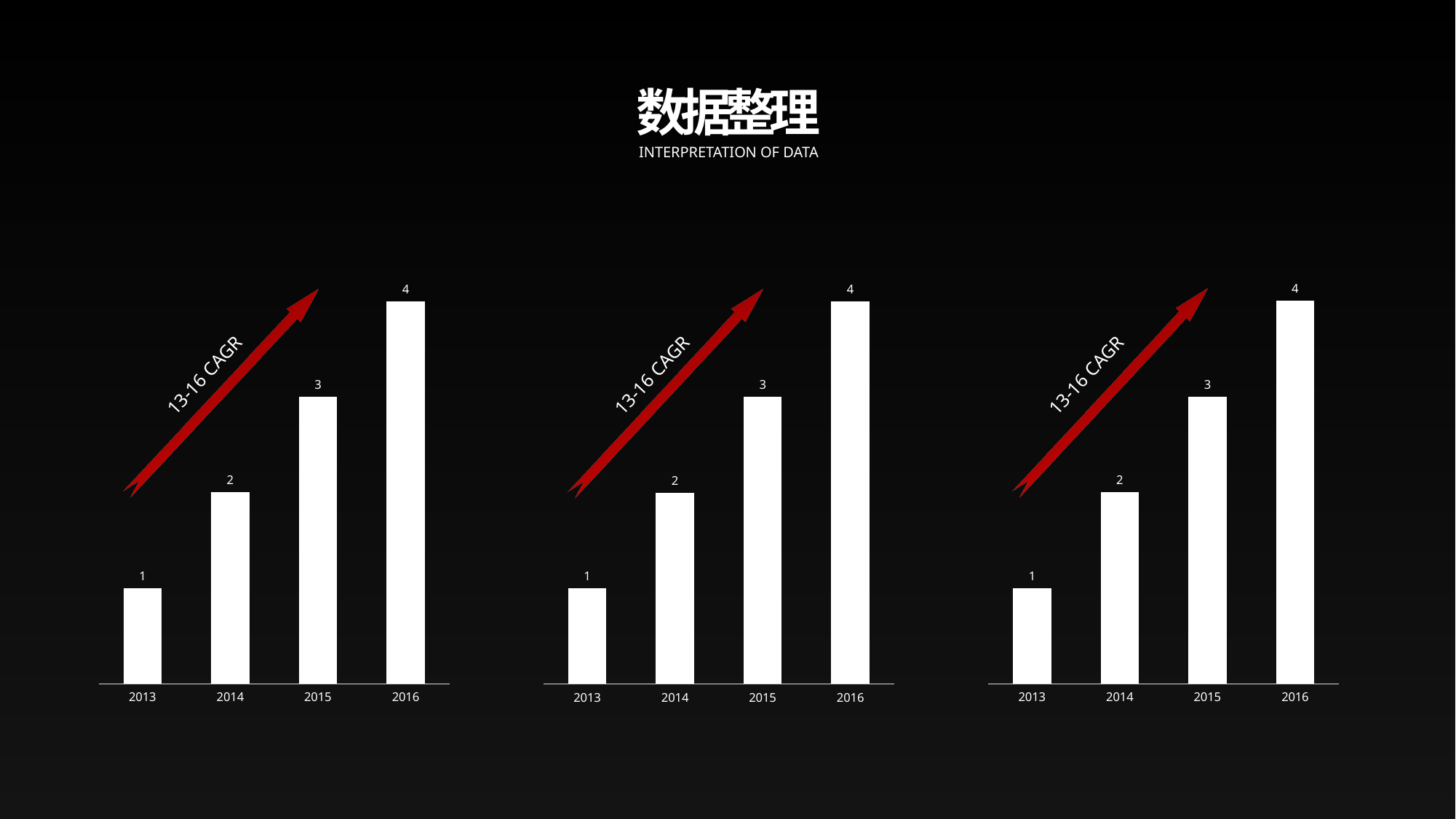
In the middle chart, what is the value for 2016? 4 What kind of chart is the right chart? bar chart How many bar charts are shown on the slide? 3 In the middle chart, what is the difference between the values for 2016 and 2013? 3 In the right chart, which year has the lowest value? 2013 In the left chart, do the values rise or fall from 2013 to 2016? rise How many years are shown on the x axis of the middle chart? 4 In the left chart, which is larger, the value for 2015 or the value for 2014? 2015 What text is written along the red arrow in the middle chart? 13-16 CAGR In the left chart, what is the value for 2014? 2 In the right chart, what is the value for 2013? 1 In the left chart, which year has the highest value? 2016